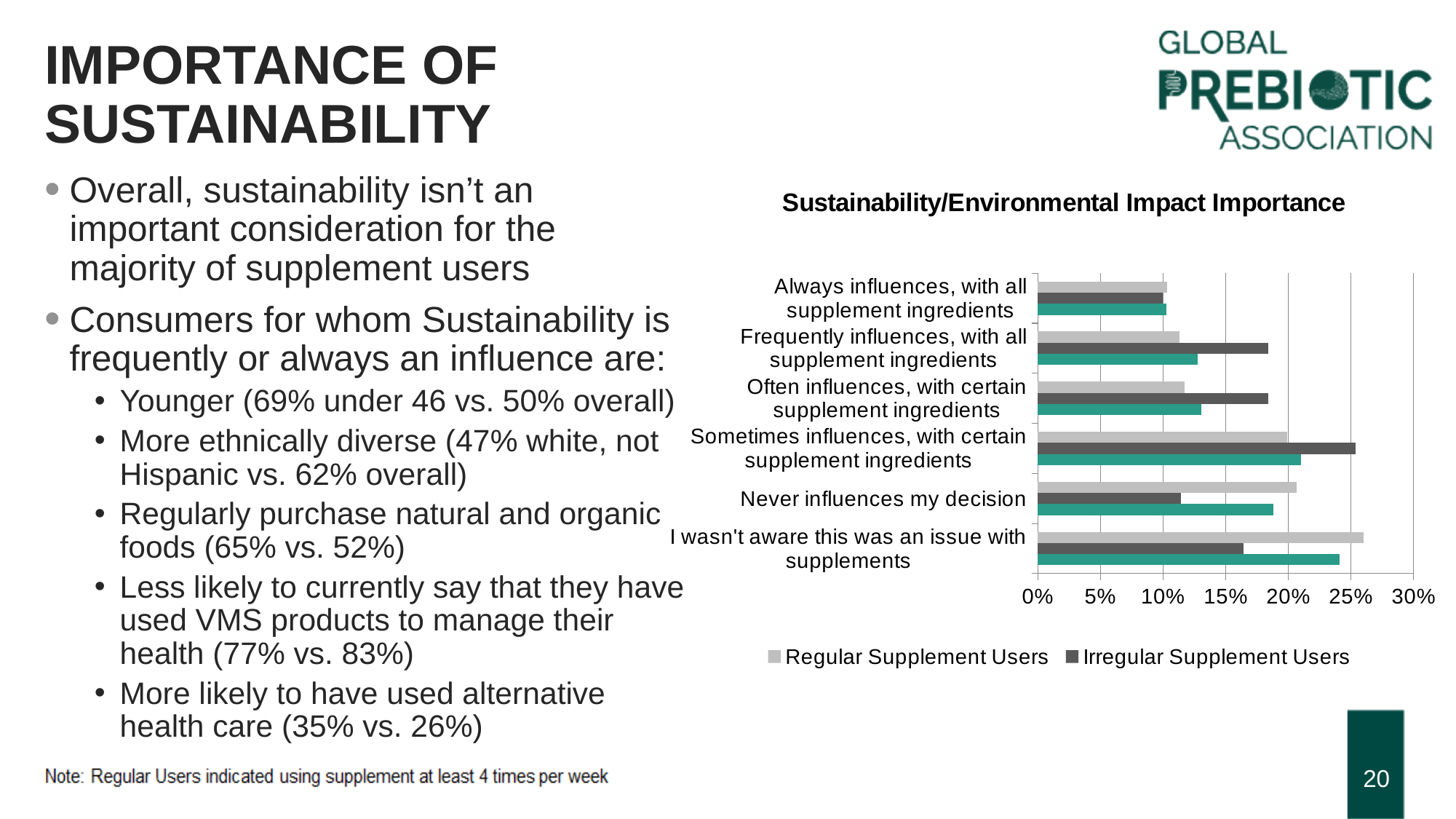
Is the value for Regular Supplement Users in 'Always influences, with all supplement ingredients' greater or less than 15%? less What is the title of the chart? Sustainability/Environmental Impact Importance How many categories are shown on the chart's vertical axis? 6 Which category has the highest value for Regular Supplement Users? I wasn't aware this was an issue with supplements Is the value for Irregular Supplement Users in 'Sometimes influences, with certain supplement ingredients' greater or less than 20%? greater For 'Never influences my decision', which group has the larger value: Regular Supplement Users or Irregular Supplement Users? Regular Supplement Users Is the value for Irregular Supplement Users in 'Never influences my decision' greater or less than 15%? less For 'Frequently influences, with all supplement ingredients', which group has the larger value: Regular Supplement Users or Irregular Supplement Users? Irregular Supplement Users Which category has the highest value for Irregular Supplement Users? Sometimes influences, with certain supplement ingredients How many series does the chart's legend list? 2 What kind of chart is shown on the slide? Bar chart